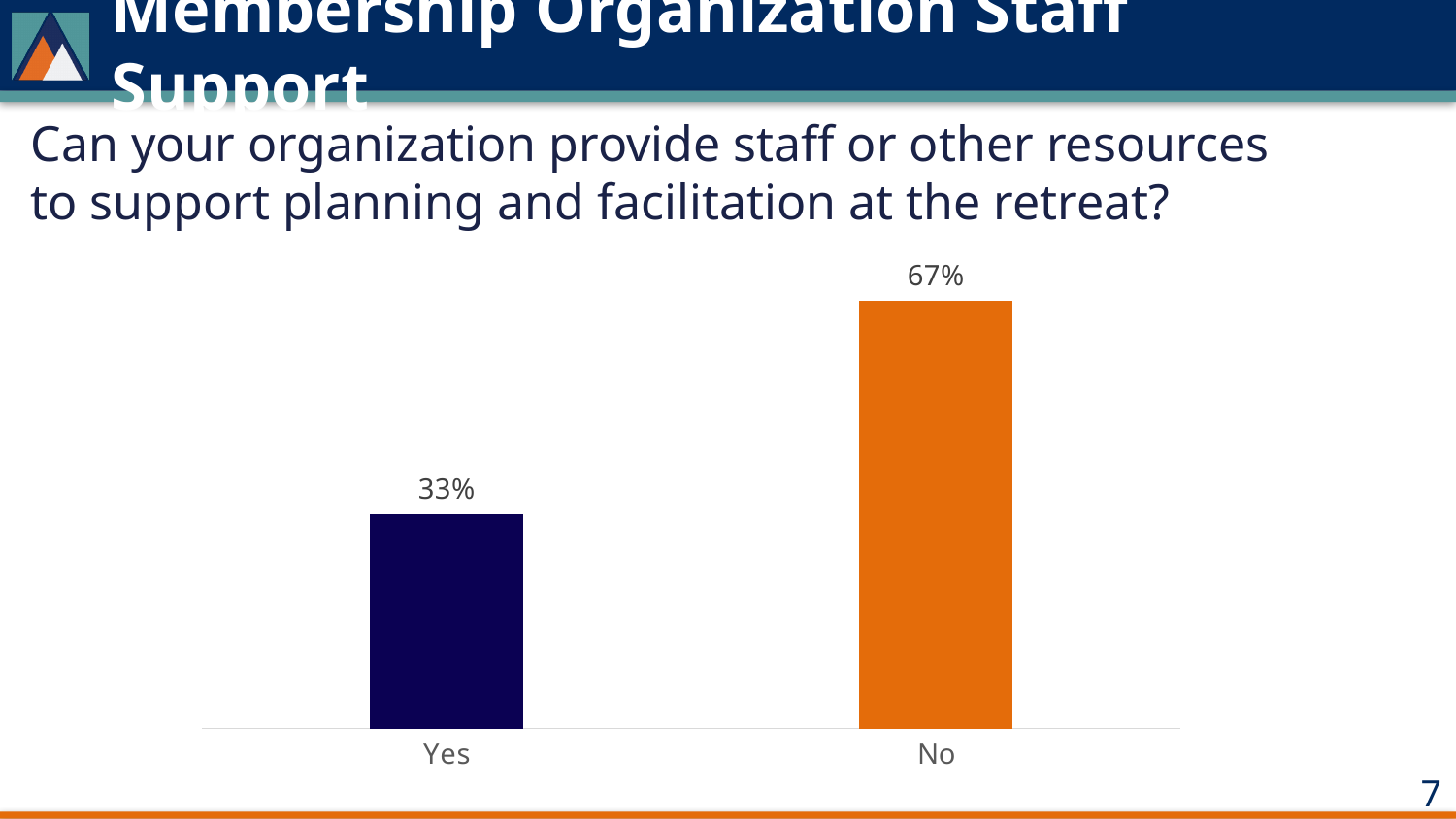
What percentage of respondents answered Yes? 33% What colour is the bar for No? Orange Which is larger, the value for Yes or the value for No? No What question does the chart present responses to? Can your organization provide staff or other resources to support planning and facilitation at the retreat? What is the difference between the No and Yes percentages? 34% Which response has the highest value? No What is the total of the Yes and No percentages? 100% Which response has the lowest value? Yes What kind of chart is shown on the slide? Bar chart What percentage of respondents answered No? 67% How many categories are shown in the chart? 2